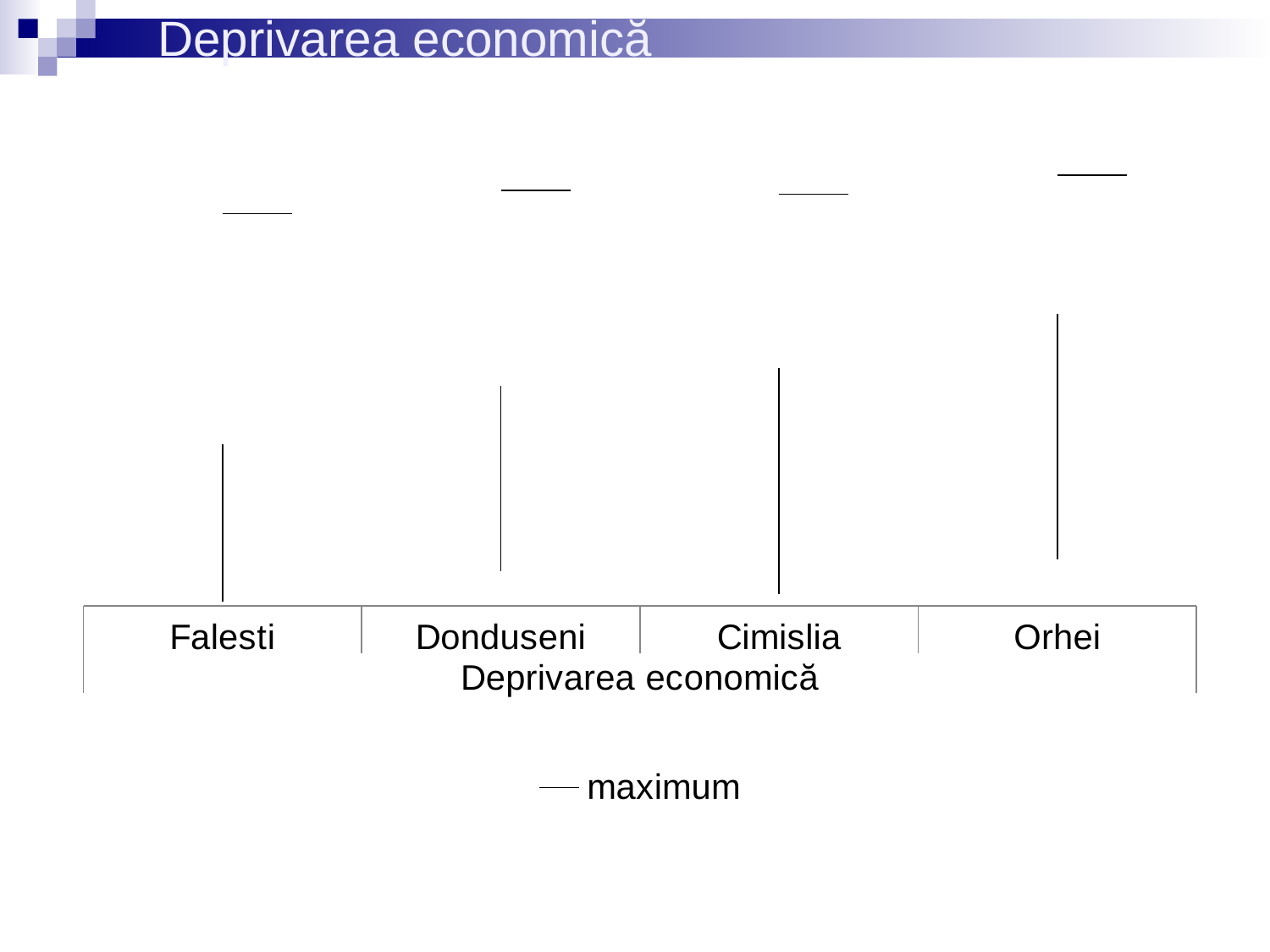
Is the 'maximum' marker for Orhei higher or lower than the one for Cimislia? higher How many series does the chart legend list? 1 Which category has the lowest 'maximum' marker? Falesti What is the entry shown in the chart legend? maximum Does the top of the vertical line for Cimislia sit higher or lower than the top of the line for Donduseni? higher What is the title shown on the chart's x axis? Deprivarea economică Which category has the highest 'maximum' marker? Orhei How many categories are shown along the x axis of the chart? 4 Which category's vertical line reaches the highest point on the chart? Orhei Is the 'maximum' marker for Orhei higher or lower than the one for Falesti? higher Which category's vertical line extends lowest on the chart? Falesti